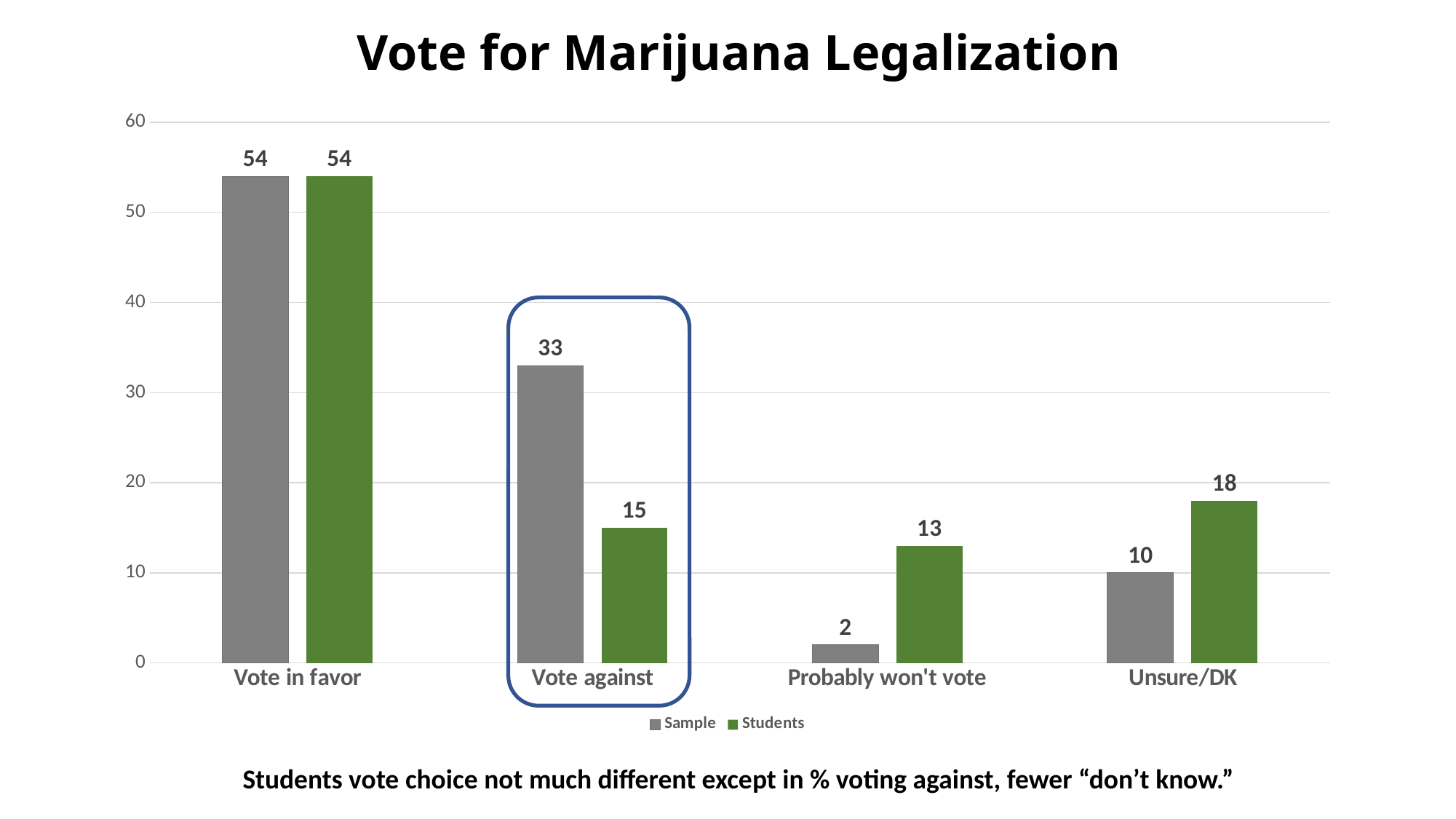
How many series does the legend list? 2 Is the Students value for Probably won't vote greater or less than 10? greater Which category has the lowest value for the Sample series? Probably won't vote What is the difference between the Sample and Students values for Vote against? 18 What kind of chart is shown on the slide? Bar chart Which category has the highest value for the Students series? Vote in favor Which is larger in the Unsure/DK category, Sample or Students? Students What is the value for Sample in the Probably won't vote category? 2 What is the title of the chart? Vote for Marijuana Legalization How many categories are shown on the x axis? 4 What is the value for Students in the Unsure/DK category? 18 What is the value for Sample in the Vote against category? 33